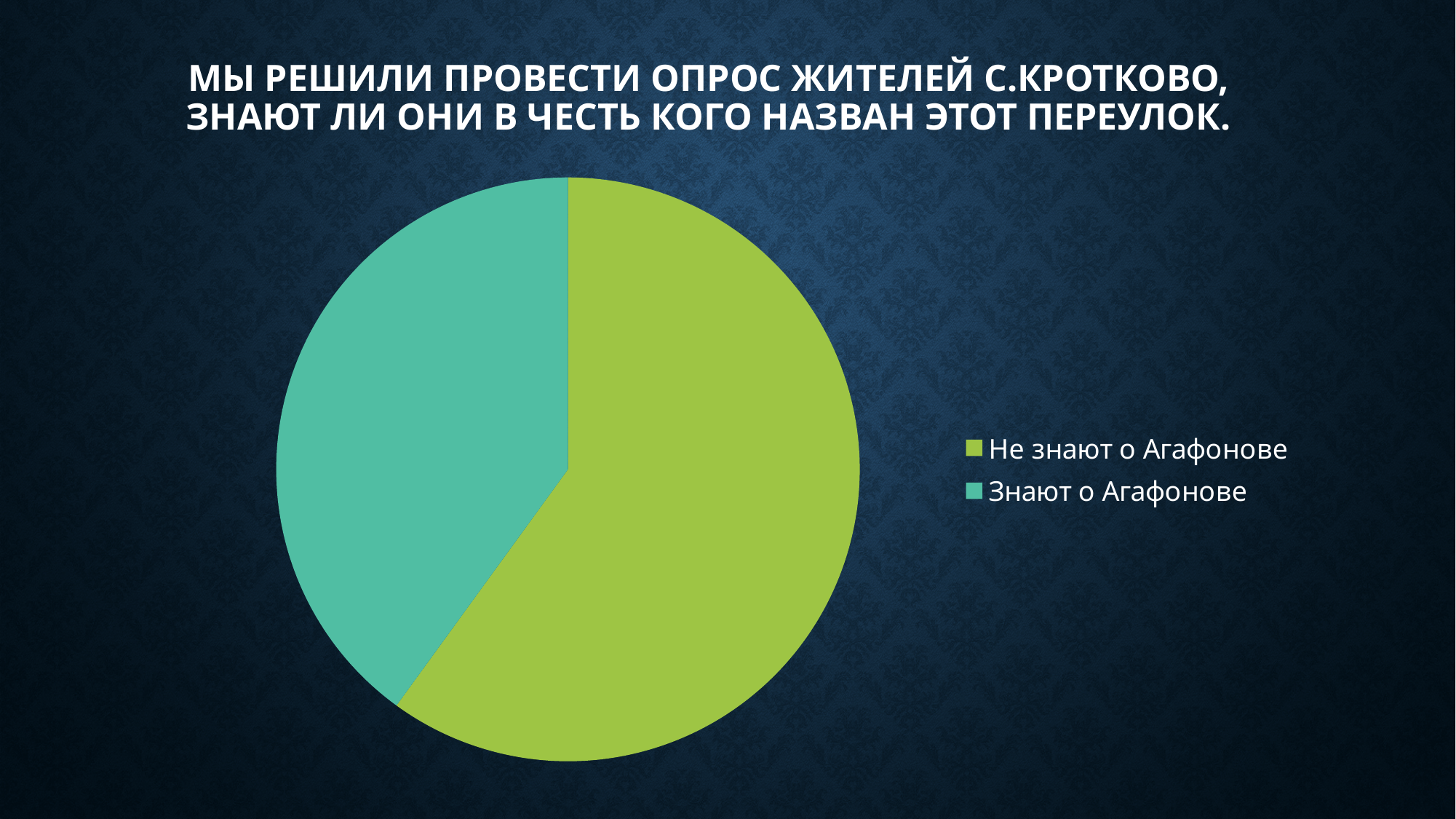
What colour is the slice for "Знают о Агафонове" in the pie chart? teal Which slice is larger: "Не знают о Агафонове" or "Знают о Агафонове"? Не знают о Агафонове How many entries does the legend of the pie chart list? 2 Which category has the smallest slice in the pie chart? Знают о Агафонове Does the slice for "Не знают о Агафонове" cover more or less than half of the pie? more Which category has the largest slice in the pie chart? Не знают о Агафонове Does the slice for "Знают о Агафонове" cover more or less than half of the pie? less What colour is the slice for "Не знают о Агафонове" in the pie chart? green How many slices does the pie chart have? 2 What kind of chart is shown on the slide? pie chart